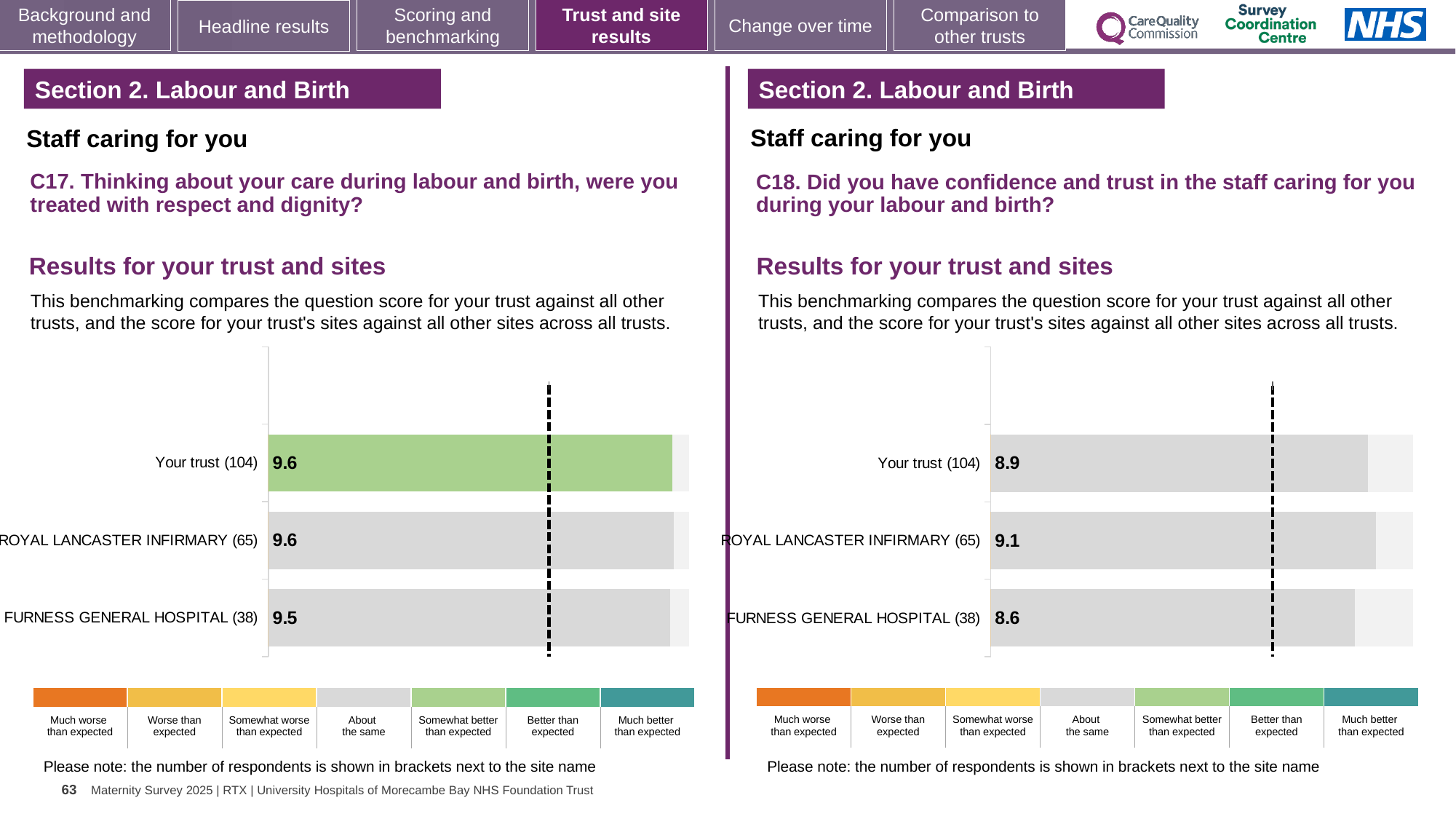
In the C18 chart on the right, which has the larger score, Your trust or Furness General Hospital? Your trust What kind of chart is used for the C18 results on the right? Bar chart In the C17 chart on the left, what is the score for Your trust? 9.6 In the C18 chart on the right, what is the difference between the scores for Royal Lancaster Infirmary and Furness General Hospital? 0.5 In the C18 chart on the right, what is the score for Your trust? 8.9 In the C17 chart on the left, how many respondents are shown in brackets for Royal Lancaster Infirmary? 65 How many bars are shown in the C17 chart on the left? 3 In the C18 chart on the right, which site or trust has the highest score? Royal Lancaster Infirmary In the C18 chart on the right, what is the score for Royal Lancaster Infirmary? 9.1 In the C18 chart on the right, which site or trust has the lowest score? Furness General Hospital In the C17 chart on the left, what is the score for Furness General Hospital? 9.5 In the C17 chart on the left, which site or trust has the lowest score? Furness General Hospital